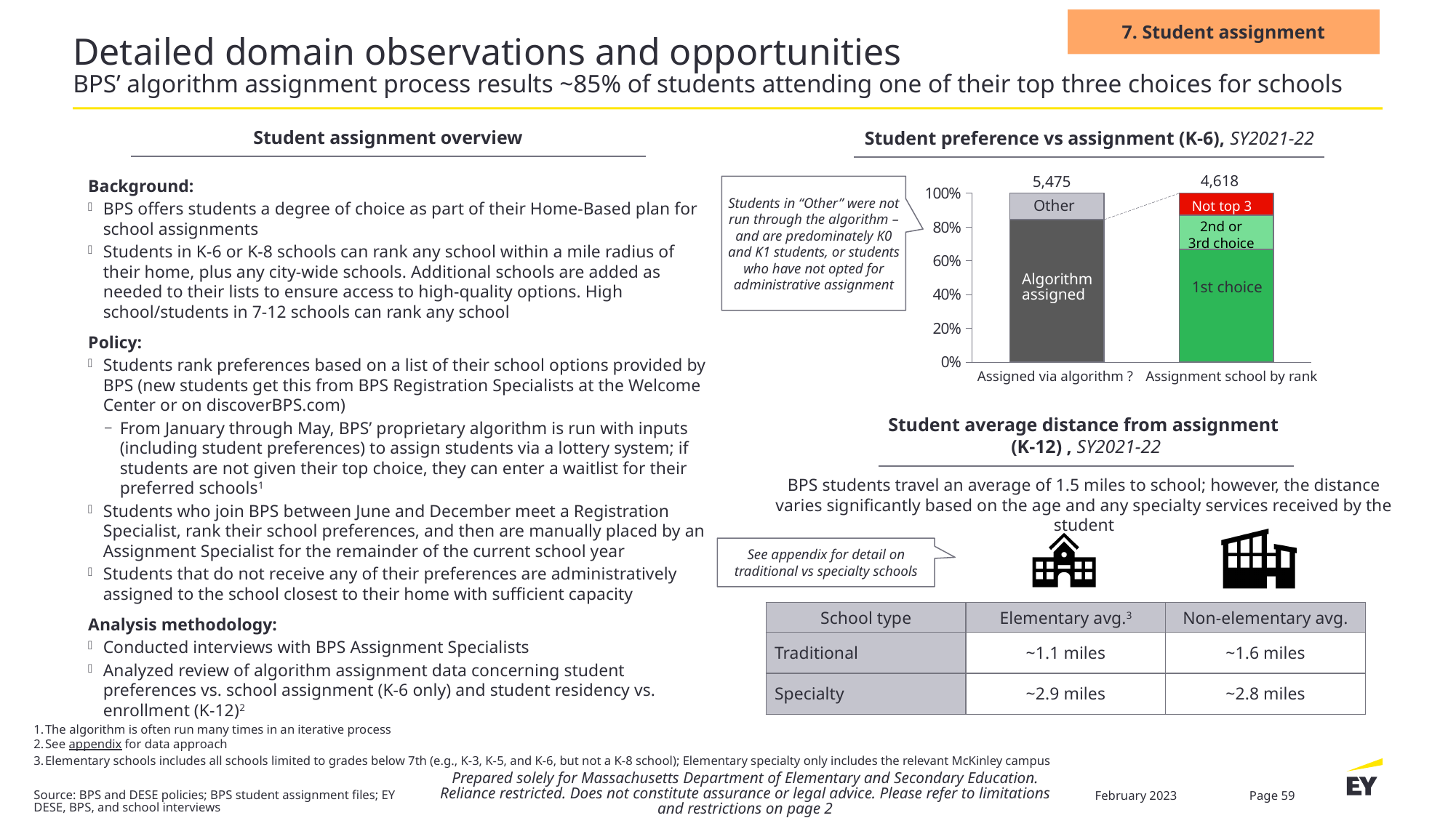
In the 'Student preference vs assignment (K-6)' chart, what colour is the 'Not top 3' segment? Red In the 'Student preference vs assignment (K-6)' chart, which bar has the larger printed total, 'Assigned via algorithm ?' or 'Assignment school by rank'? Assigned via algorithm ? In the 'Student preference vs assignment (K-6)' chart, what is the highest tick shown on the y-axis? 100% In the 'Student preference vs assignment (K-6)' chart, is the share of the 'Algorithm assigned' segment greater or less than 80%? greater In the 'Student preference vs assignment (K-6)' chart, which segment is the largest in the 'Assignment school by rank' bar? 1st choice In the 'Student preference vs assignment (K-6)' chart, how many bars are plotted? 2 In the 'Student preference vs assignment (K-6)' chart, is the share of the 'Other' segment greater or less than 20%? less In the 'Student preference vs assignment (K-6)' chart, what total is printed above the 'Assignment school by rank' bar? 4,618 What kind of chart is shown under 'Student preference vs assignment (K-6), SY2021-22'? Stacked bar chart In the 'Student preference vs assignment (K-6)' chart, is the share of the '1st choice' segment greater or less than 60%? greater In the 'Student preference vs assignment (K-6)' chart, what is the difference between the printed totals 5,475 and 4,618? 857 In the 'Student preference vs assignment (K-6)' chart, what total is printed above the 'Assigned via algorithm ?' bar? 5,475